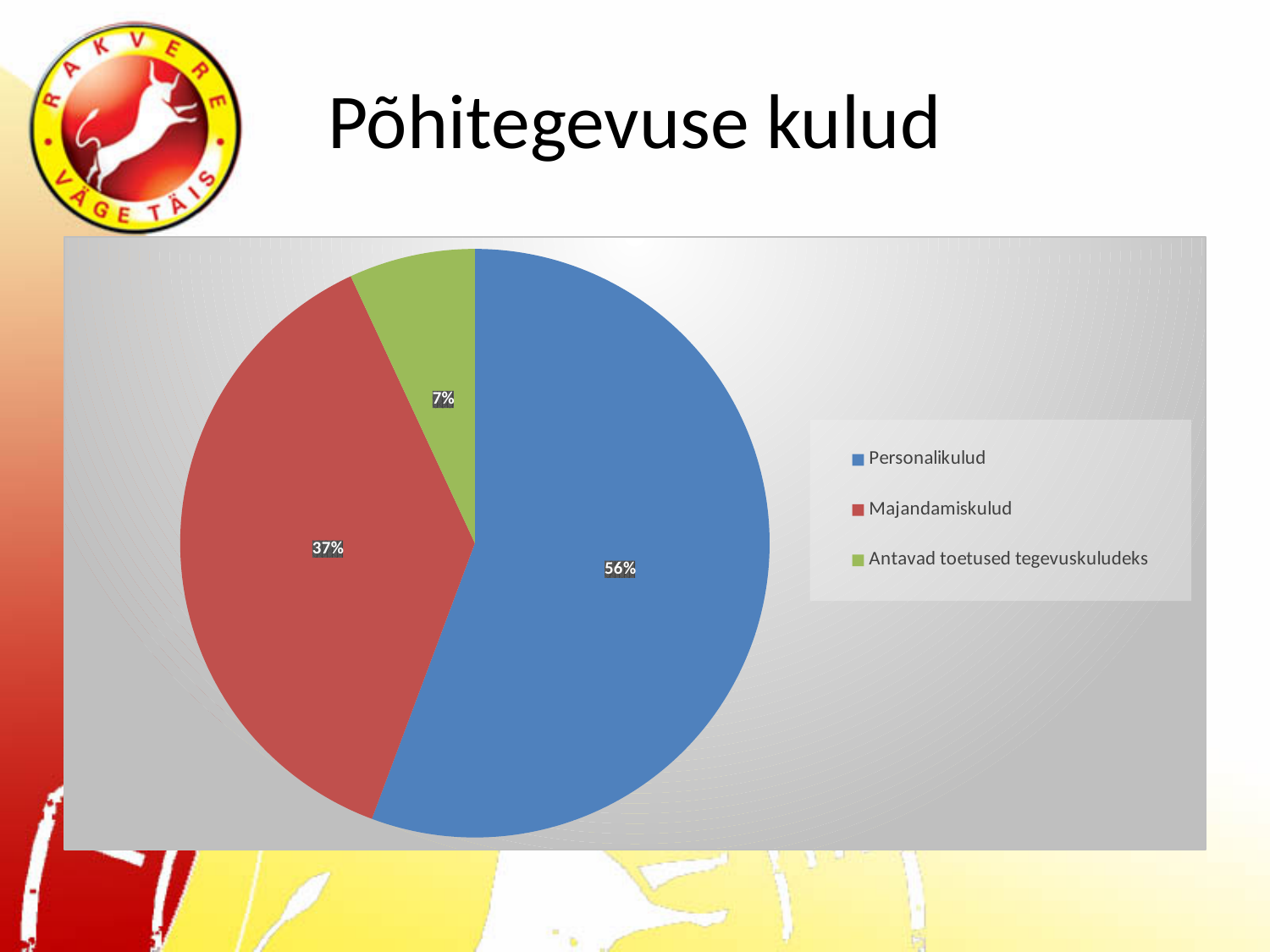
Which category has the largest slice of the pie? Personalikulud What share of the pie does Majandamiskulud have? 37% How many categories does the pie chart have? 3 What is the difference in percentage points between Personalikulud and Majandamiskulud? 19 Which category has the smallest slice of the pie? Antavad toetused tegevuskuludeks What is the difference in percentage points between Majandamiskulud and Antavad toetused tegevuskuludeks? 30 Which is larger, Majandamiskulud or Antavad toetused tegevuskuludeks? Majandamiskulud What colour is the slice for Majandamiskulud? red What kind of chart is shown on the slide? pie chart What share of the pie does Personalikulud have? 56% What is the title of the slide containing the chart? Põhitegevuse kulud What share of the pie does Antavad toetused tegevuskuludeks have? 7%